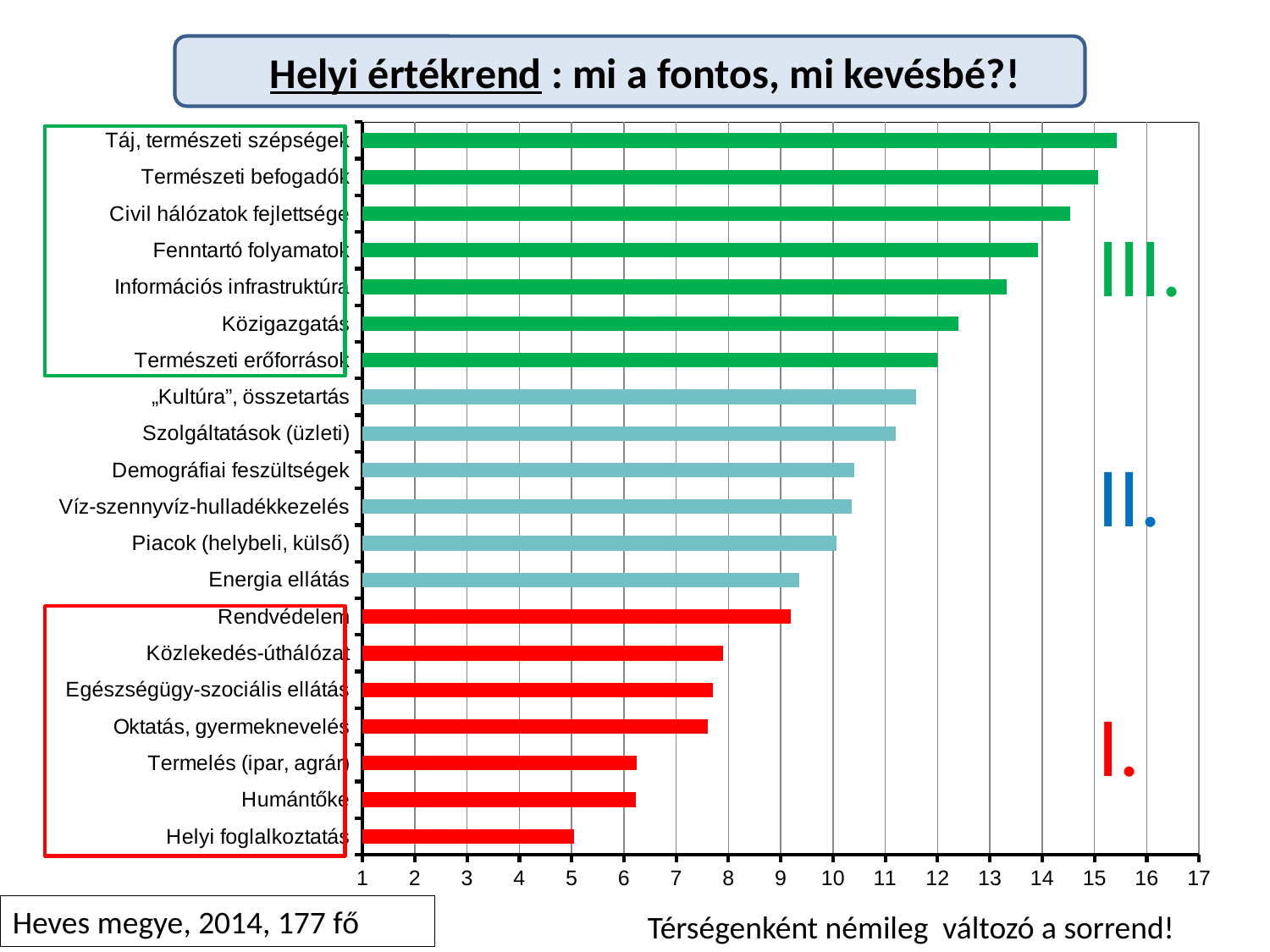
Is the value for Helyi foglalkoztatás greater or less than 6? less What kind of chart is shown on the slide? bar chart Is the value for Rendvédelem greater or less than 10? less Which category has the lowest value in the chart? Helyi foglalkoztatás How many categories are plotted in the chart? 20 Is the value for Táj, természeti szépségek greater or less than 15? greater How many different bar colours are used in the chart? 3 Which category has the highest value in the chart? Táj, természeti szépségek Do the bar values increase or decrease going from the top category to the bottom category? decrease Which has a larger value, Energia ellátás or Szolgáltatások (üzleti)? Szolgáltatások (üzleti) Which has a larger value, Közigazgatás or Rendvédelem? Közigazgatás